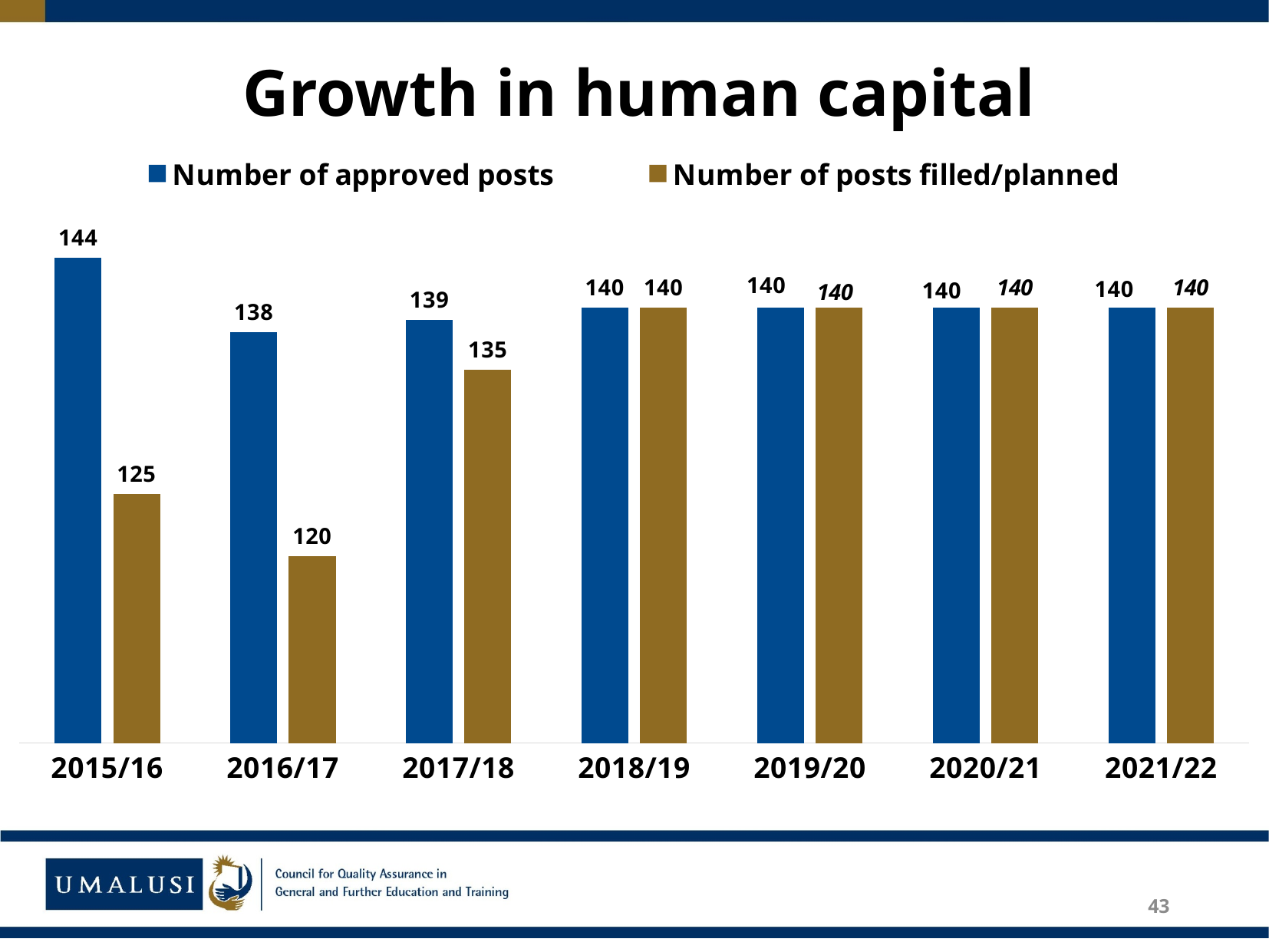
How many years are shown on the x axis? 7 What is the difference between the number of approved posts and the number of posts filled/planned in 2015/16? 19 What is the difference between the number of approved posts and the number of posts filled/planned in 2016/17? 18 Which year has the lowest number of posts filled/planned? 2016/17 Which is larger in 2017/18: the number of approved posts or the number of posts filled/planned? Number of approved posts How many series does the legend list? 2 What kind of chart is shown on the slide? Bar chart What is the number of approved posts in 2015/16? 144 What is the number of posts filled/planned in 2017/18? 135 What is the number of posts filled/planned in 2016/17? 120 What is the title of the chart? Growth in human capital Which year has the highest number of approved posts? 2015/16